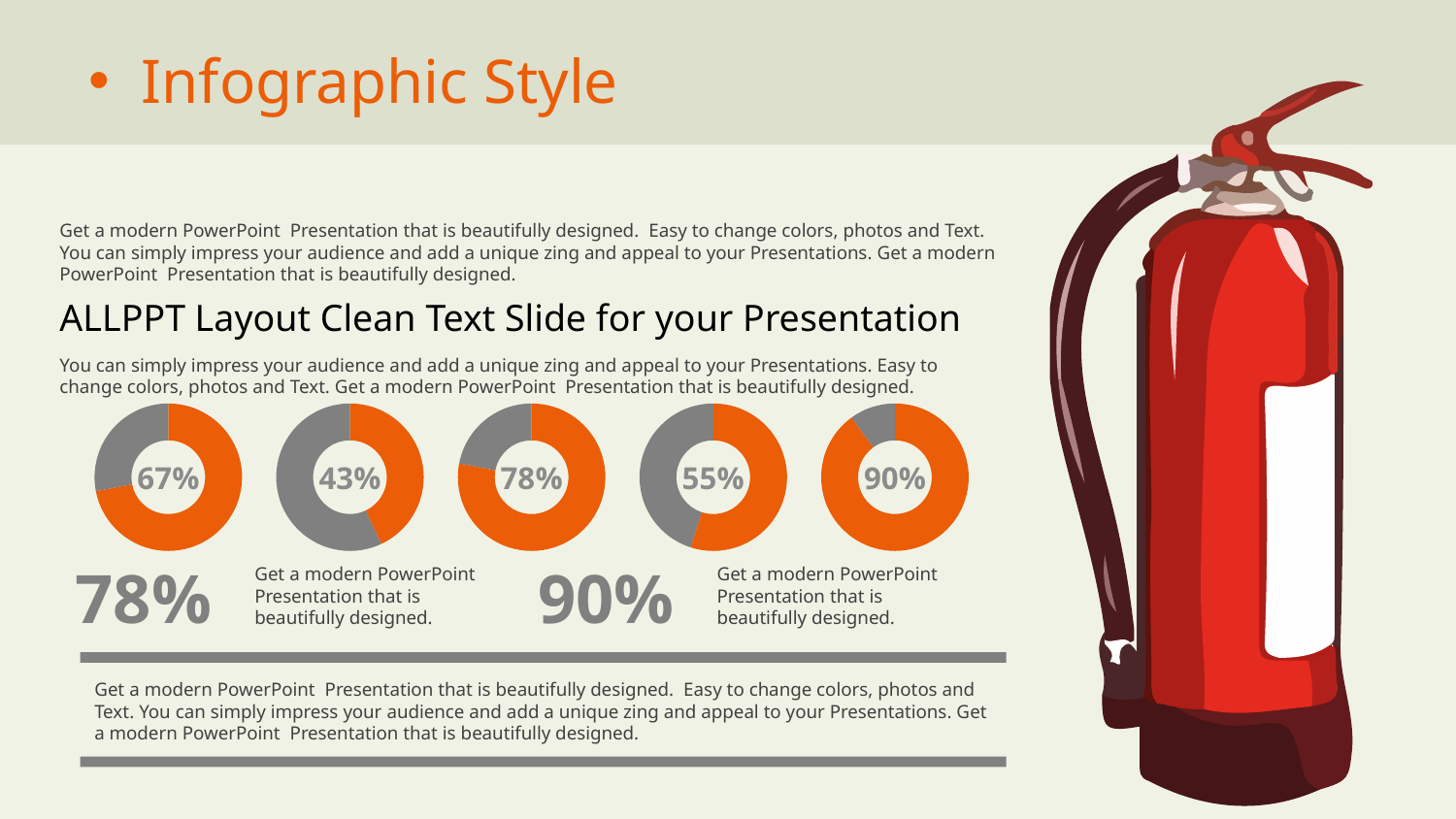
How many donut charts are shown on the slide? 5 What value is shown in the centre of the middle (third) donut chart? 78% Which donut chart shows the lowest percentage? The second from the left (43%) What is the difference between the percentage in the rightmost donut chart and the percentage in the leftmost donut chart? 23% Which is larger, the percentage in the middle donut chart or the percentage in the fourth donut chart from the left? The middle donut chart (78%) What colour is used for the filled (percentage) portion of each donut chart? Orange What value is shown in the centre of the leftmost donut chart? 67% What value is shown in the centre of the second donut chart from the left? 43% What value is shown in the centre of the rightmost donut chart? 90% What value is shown in the centre of the fourth donut chart from the left? 55% What type of chart is used for the five percentage figures on the slide? Donut (pie) chart Which donut chart shows the highest percentage? The rightmost one (90%)